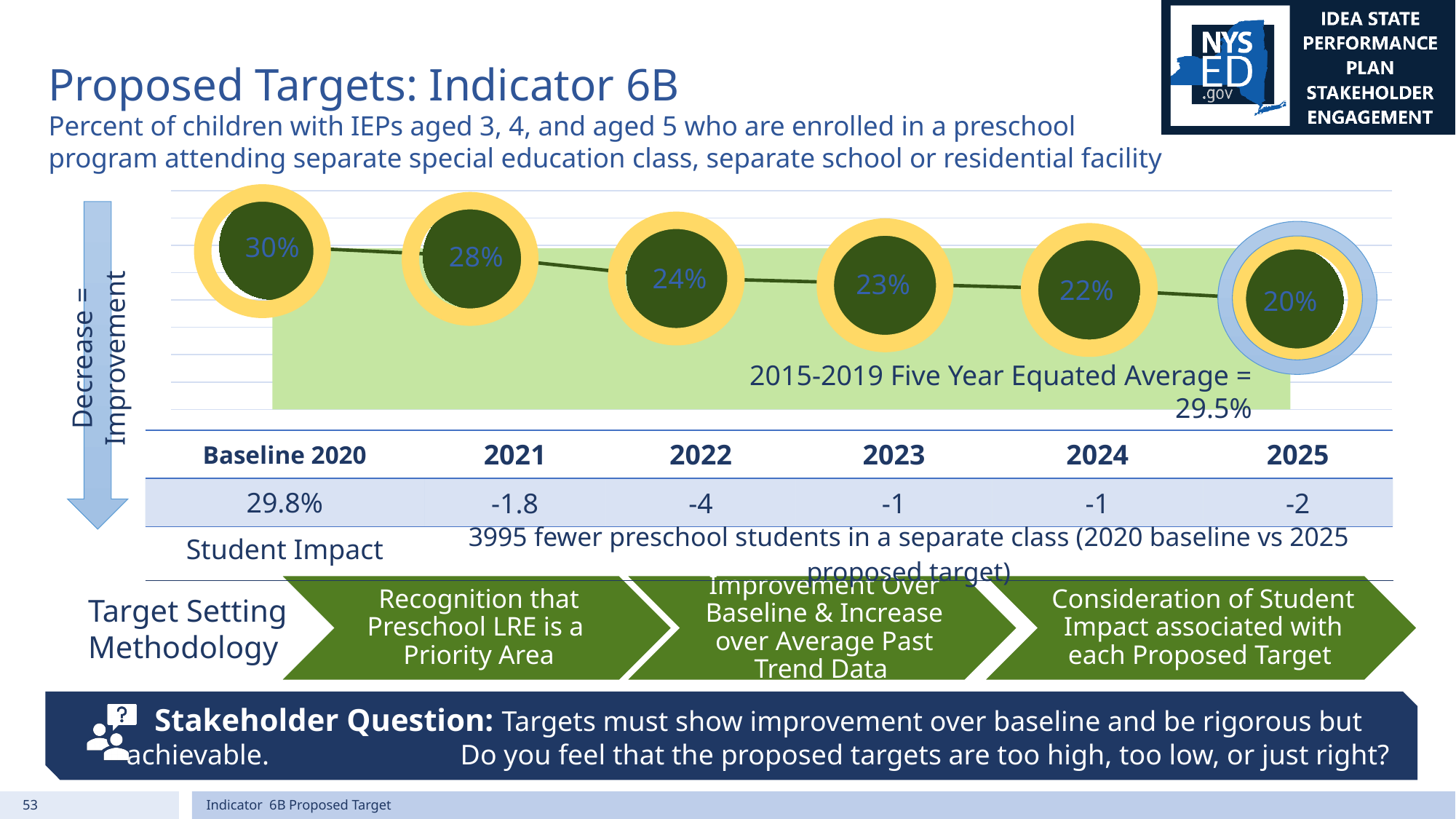
What is the difference between the Baseline 2020 value and the 2025 value? 10% What value is shown for 2022 on the chart? 24% What is the difference between the 2022 value and the 2024 value? 2% What value is shown for 2025 on the chart? 20% How many data points are plotted on the chart? 6 What is the 2015-2019 Five Year Equated Average shown on the chart? 29.5% Do the values rise or fall from Baseline 2020 to 2025? fall Which is larger, the value for 2021 or the value for 2023? 2021 Which year has the lowest value on the chart? 2025 What kind of chart is shown on the slide? line chart Which point has the highest value on the chart? Baseline 2020 What value is shown for the Baseline 2020 point on the chart? 30%